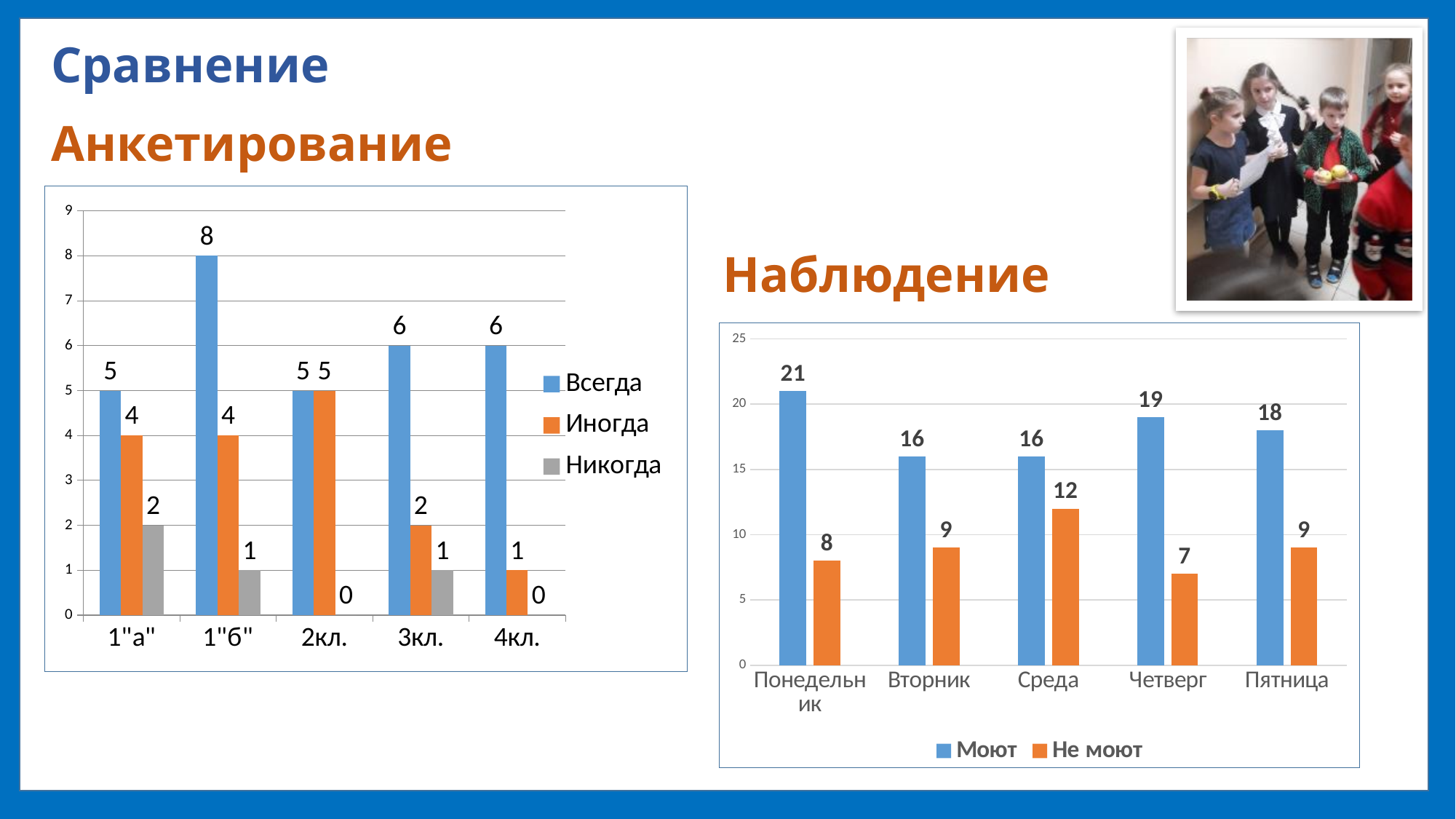
In the Наблюдение chart on the right, which day has the lowest Не моют value? Четверг In the Анкетирование chart on the left, which class has the highest Всегда value? 1"б" In the Наблюдение chart on the right, what is the value of Моют for Понедельник? 21 In the Анкетирование chart on the left, what is the difference between Всегда and Иногда for 3кл.? 4 What kind of chart is the Наблюдение chart on the right? Bar chart In the Наблюдение chart on the right, which day has the highest Не моют value? Среда In the Анкетирование chart on the left, how many classes are shown on the x axis? 5 In the Анкетирование chart on the left, what is the value of Всегда for 1"б"? 8 In the Анкетирование chart on the left, how many series does the legend list? 3 In the Наблюдение chart on the right, which is larger: Моют for Пятница or Моют for Вторник? Моют for Пятница In the Наблюдение chart on the right, what is the difference between Моют and Не моют for Четверг? 12 In the Анкетирование chart on the left, what is the value of Никогда for 1"а"? 2